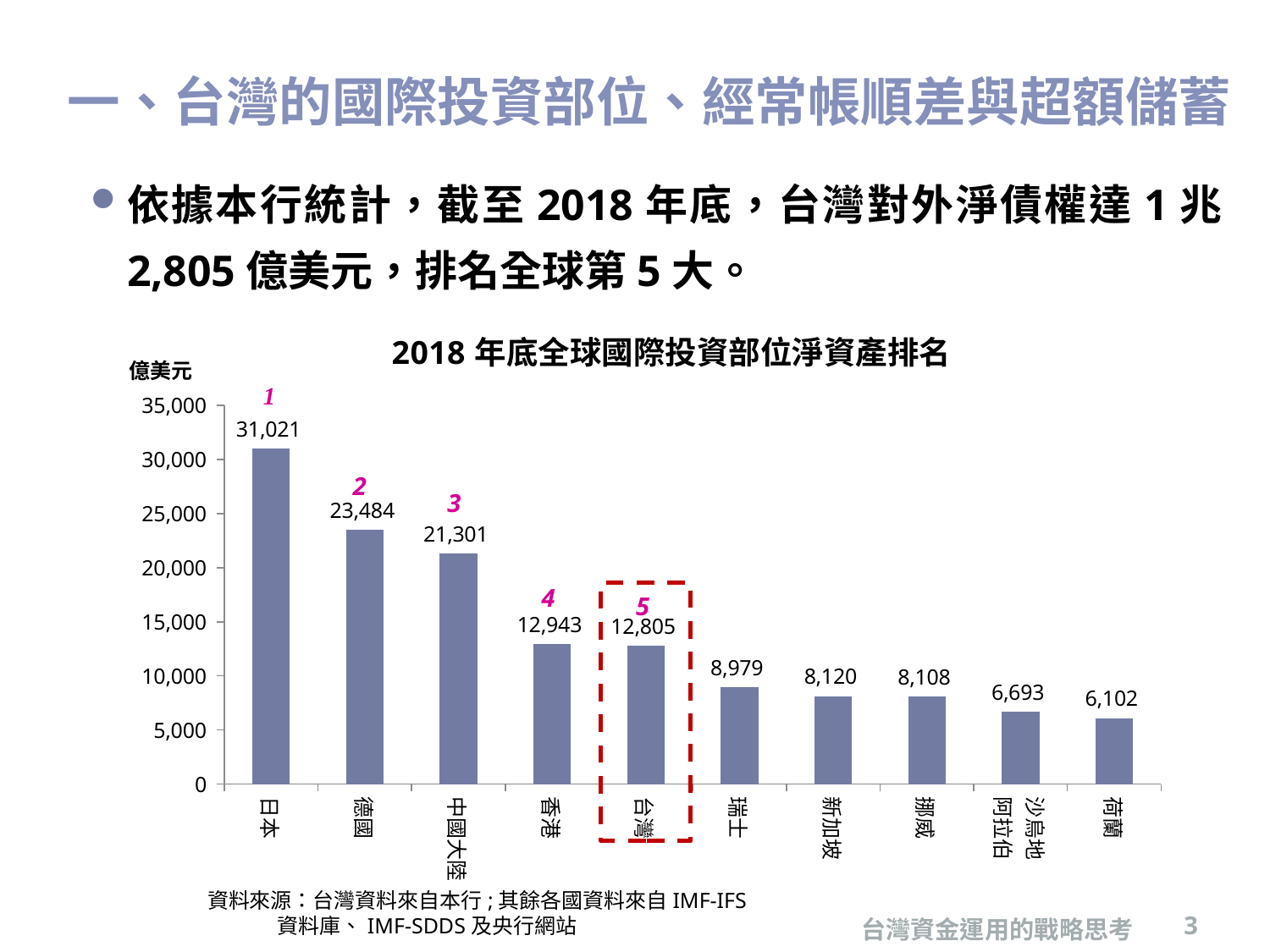
Which category has the highest value in the chart? 日本 What is the difference between the values for 德國 and 中國大陸? 2,183 What is the value for 日本 in the chart? 31,021 What is the value for 台灣 in the chart? 12,805 What kind of chart is shown on the slide? bar chart How many categories are shown in the chart? 10 What is the title of the chart? 2018 年底全球國際投資部位淨資產排名 What is the value for 沙烏地阿拉伯 in the chart? 6,693 What is the difference between the values for 香港 and 台灣? 138 Which is larger, the value for 新加坡 or the value for 荷蘭? 新加坡 What is the value for 瑞士 in the chart? 8,979 Which category has the lowest value in the chart? 荷蘭